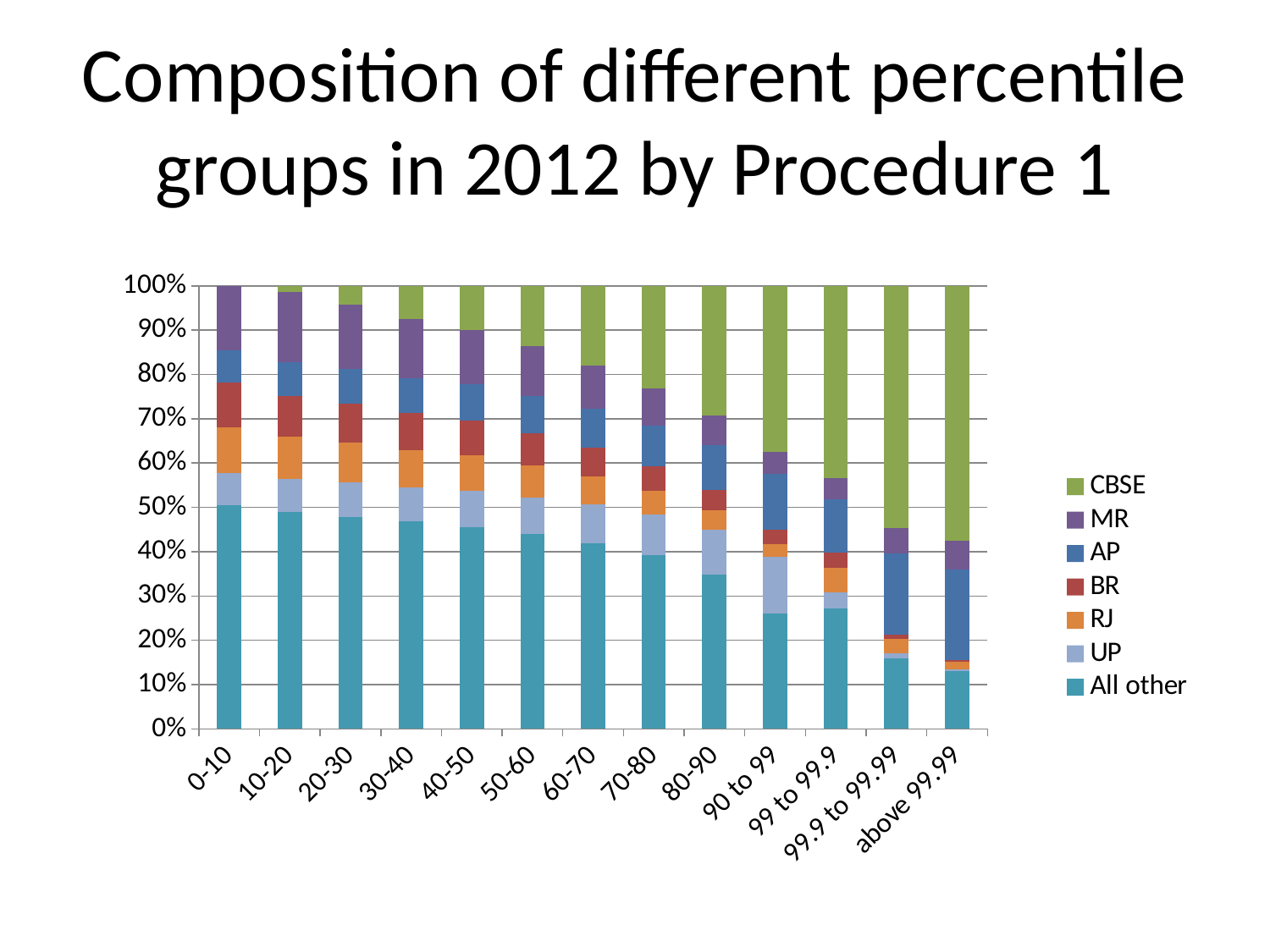
Does the CBSE share rise or fall as you move from the 0-10 group to the 'above 99.99' group? rise How many series does the legend list? 7 Is the 'All other' share for the 0-10 percentile group greater or less than 40%? greater Does the 'All other' share rise or fall as you move from the 0-10 group to the 'above 99.99' group? fall Which series is listed first (at the top) in the legend? CBSE How many percentile groups are shown along the x axis? 13 What kind of chart is shown on the slide? Stacked bar chart Is the 'All other' share for the 'above 99.99' group greater or less than 20%? less Is the 'All other' share for the '90 to 99' group greater or less than 20%? greater Which has the larger 'All other' share: the 0-10 group or the 'above 99.99' group? 0-10 What is the total height of each stacked bar? 100% What is the title of the chart on the slide? Composition of different percentile groups in 2012 by Procedure 1